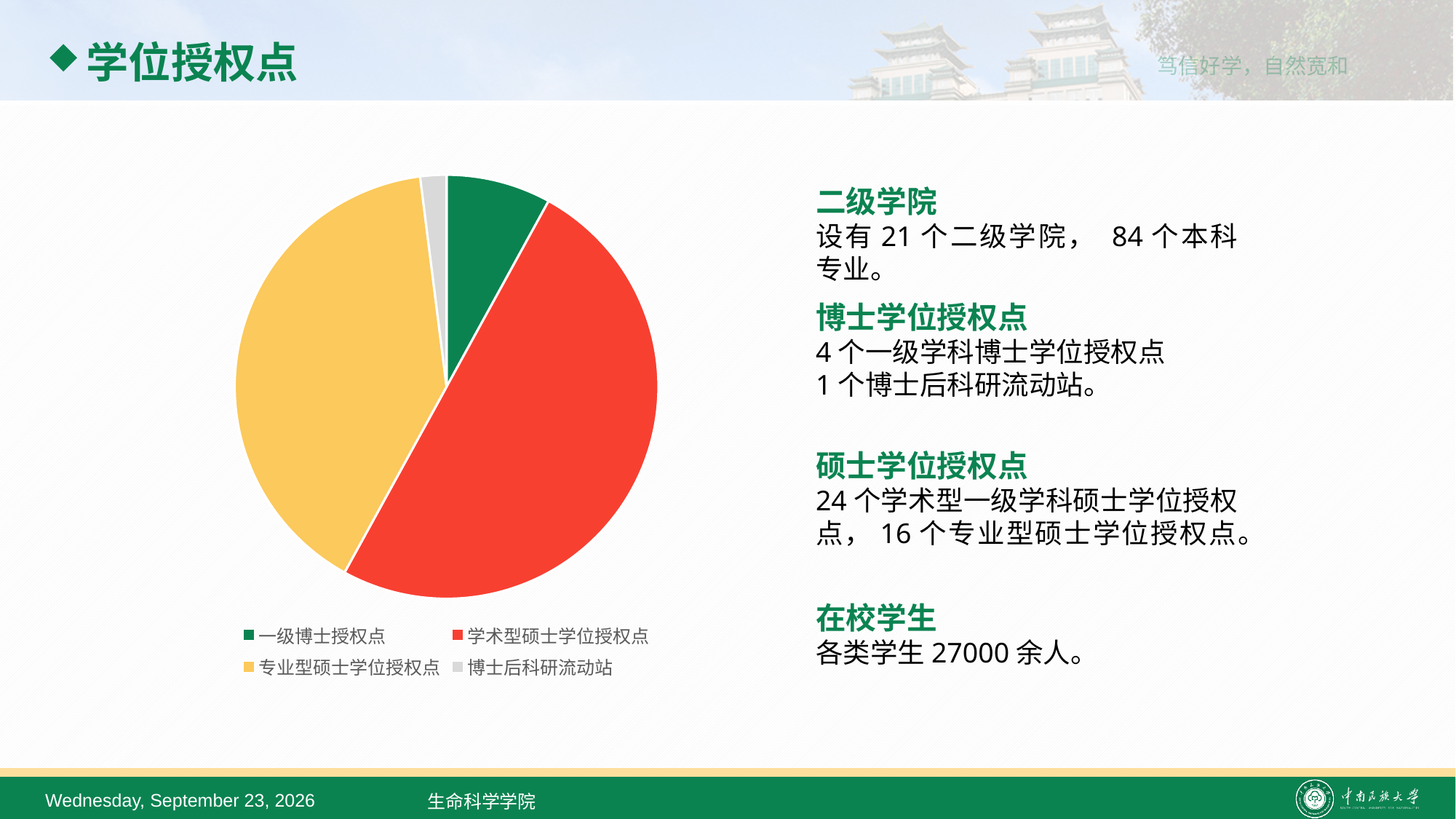
What kind of chart is shown on the slide? pie chart Which category does the yellow slice of the pie chart represent? 专业型硕士学位授权点 Which category has the smallest slice in the pie chart? 博士后科研流动站 Which category has the largest slice in the pie chart? 学术型硕士学位授权点 Which slice is larger in the pie chart: 学术型硕士学位授权点 or 专业型硕士学位授权点? 学术型硕士学位授权点 How many slices does the pie chart have? 4 What colour is the 学术型硕士学位授权点 slice in the pie chart? red Which slice is larger in the pie chart: 一级博士授权点 or 博士后科研流动站? 一级博士授权点 Which slice is larger in the pie chart: 专业型硕士学位授权点 or 一级博士授权点? 专业型硕士学位授权点 How many entries does the pie chart's legend list? 4